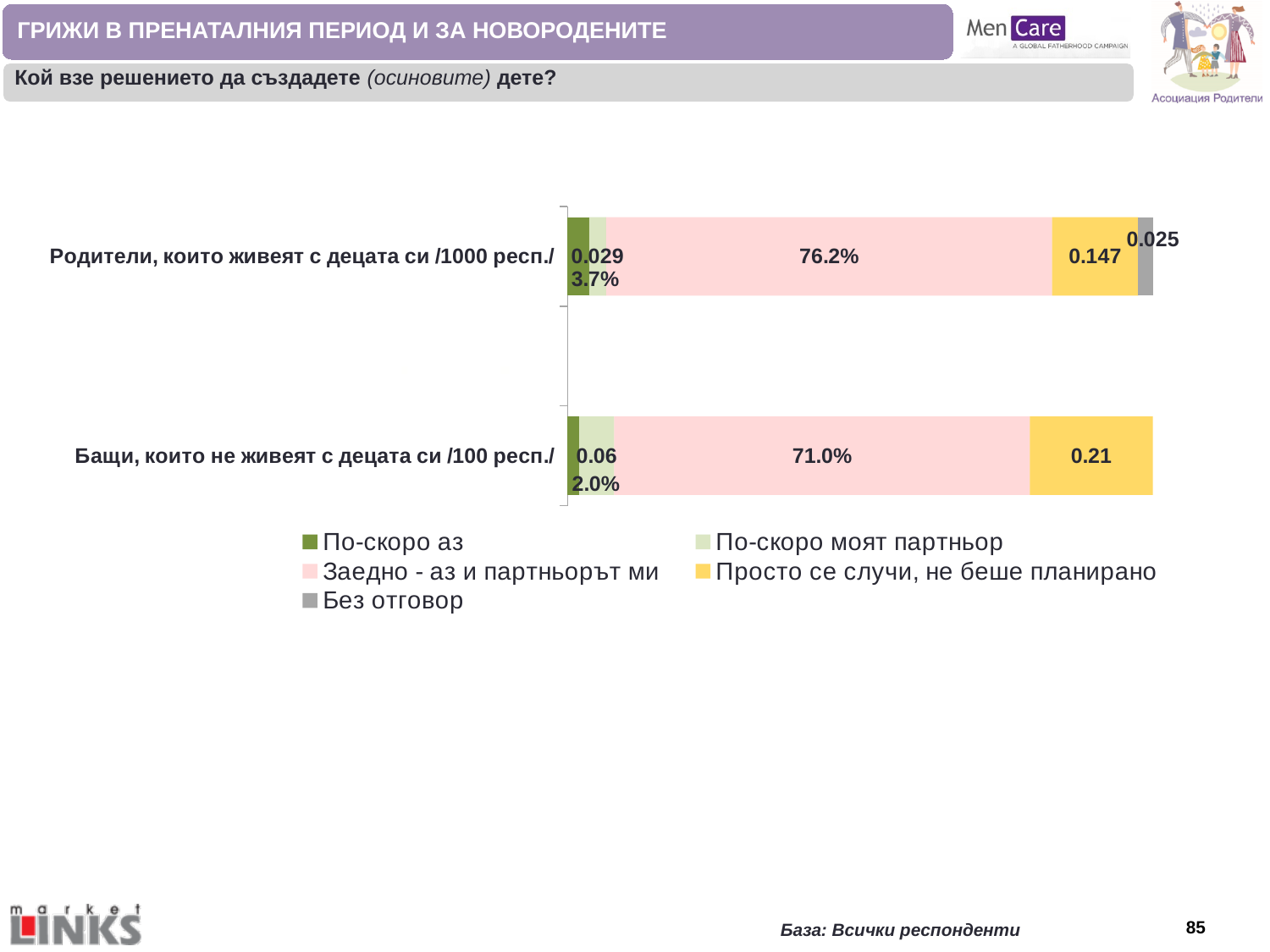
Which category has the larger value for "Заедно - аз и партньорът ми"? Родители, които живеят с децата си /1000 респ./ Which series has the largest share in the bar for "Бащи, които не живеят с децата си /100 респ./"? Заедно - аз и партньорът ми What is the value of "Без отговор" for "Родители, които живеят с децата си /1000 респ./"? 0.025 How many categories (bars) are plotted in the chart? 2 How many series does the chart legend list? 5 What is the value of "Просто се случи, не беше планирано" for "Родители, които живеят с децата си /1000 респ./"? 0.147 What is the value of "Просто се случи, не беше планирано" for "Бащи, които не живеят с децата си /100 респ./"? 0.21 What is the value of "Заедно - аз и партньорът ми" for "Родители, които живеят с децата си /1000 респ./"? 76.2% What is the difference between the "Заедно - аз и партньорът ми" values for the two categories? 5.2 percentage points What kind of chart is shown on the slide? Stacked bar chart What is the value of "Заедно - аз и партньорът ми" for "Бащи, които не живеят с децата си /100 респ./"? 71.0% What colour represents "Заедно - аз и партньорът ми" in the chart? Light pink